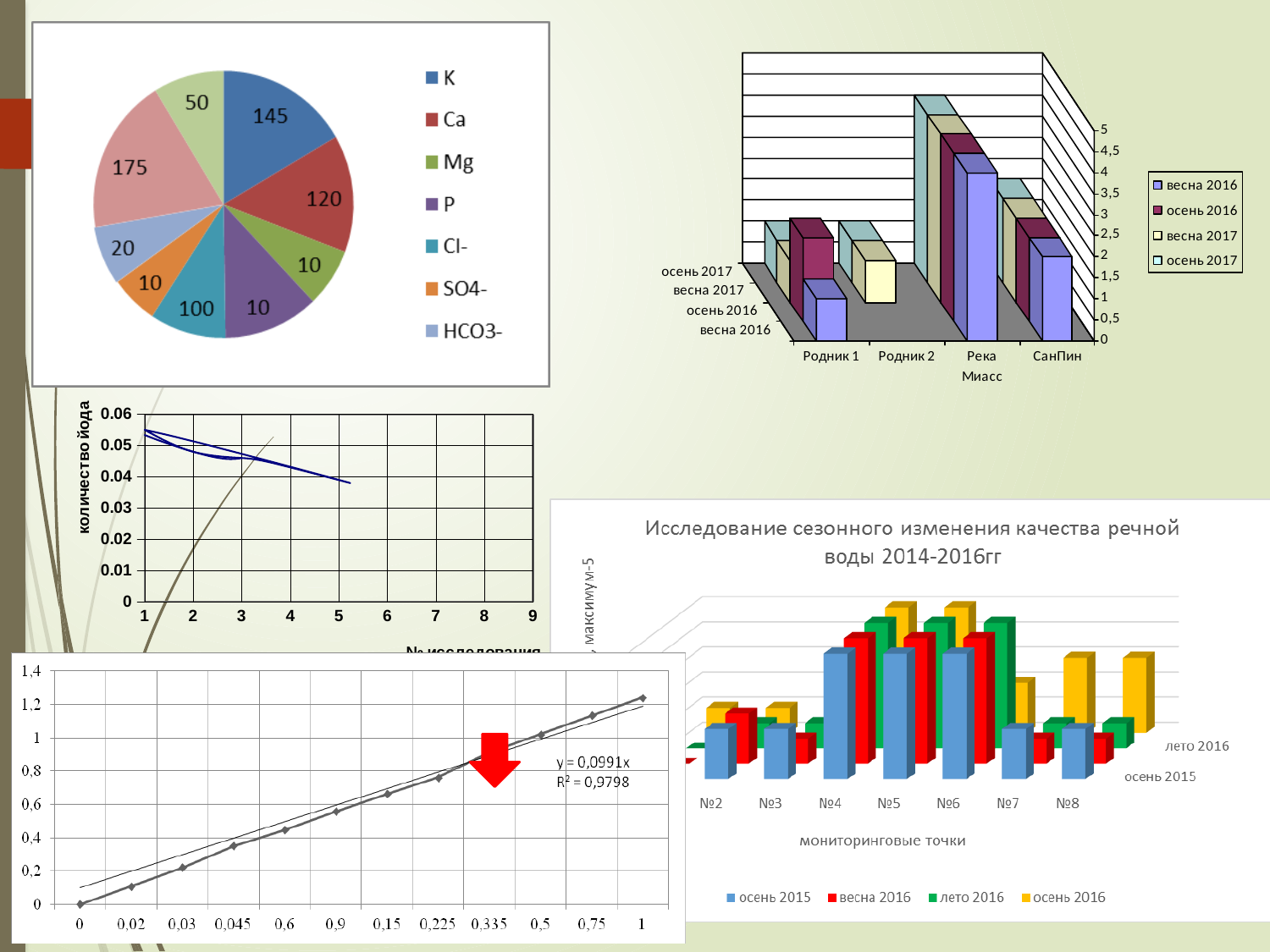
In the pie chart at the top left, what is the difference between the values for K and Ca? 25 In the chart titled 'Исследование сезонного изменения качества речной воды 2014-2016гг', which series is shown in yellow? осень 2016 In the chart titled 'Исследование сезонного изменения качества речной воды 2014-2016гг', how many monitoring points (categories) are shown on the x axis? 7 In the 3D bar chart at the top right, how many series does the legend list? 4 In the chart at the bottom left with the red arrow, what is the trendline equation shown? y = 0,0991x In the pie chart at the top left, what is the value for Ca? 120 In the pie chart at the top left, what is the value for Cl-? 100 In the 3D bar chart at the top right, is the value for Река Миасс in весна 2016 greater or less than 3? greater In the chart with the y axis labelled 'количество йода', do the values rise or fall as the x axis increases? fall In the pie chart at the top left, how many slices does the pie have? 9 In the pie chart at the top left, what is the value for K? 145 In the pie chart at the top left, which is larger, the value for Cl- or the value for HCO3-? Cl-